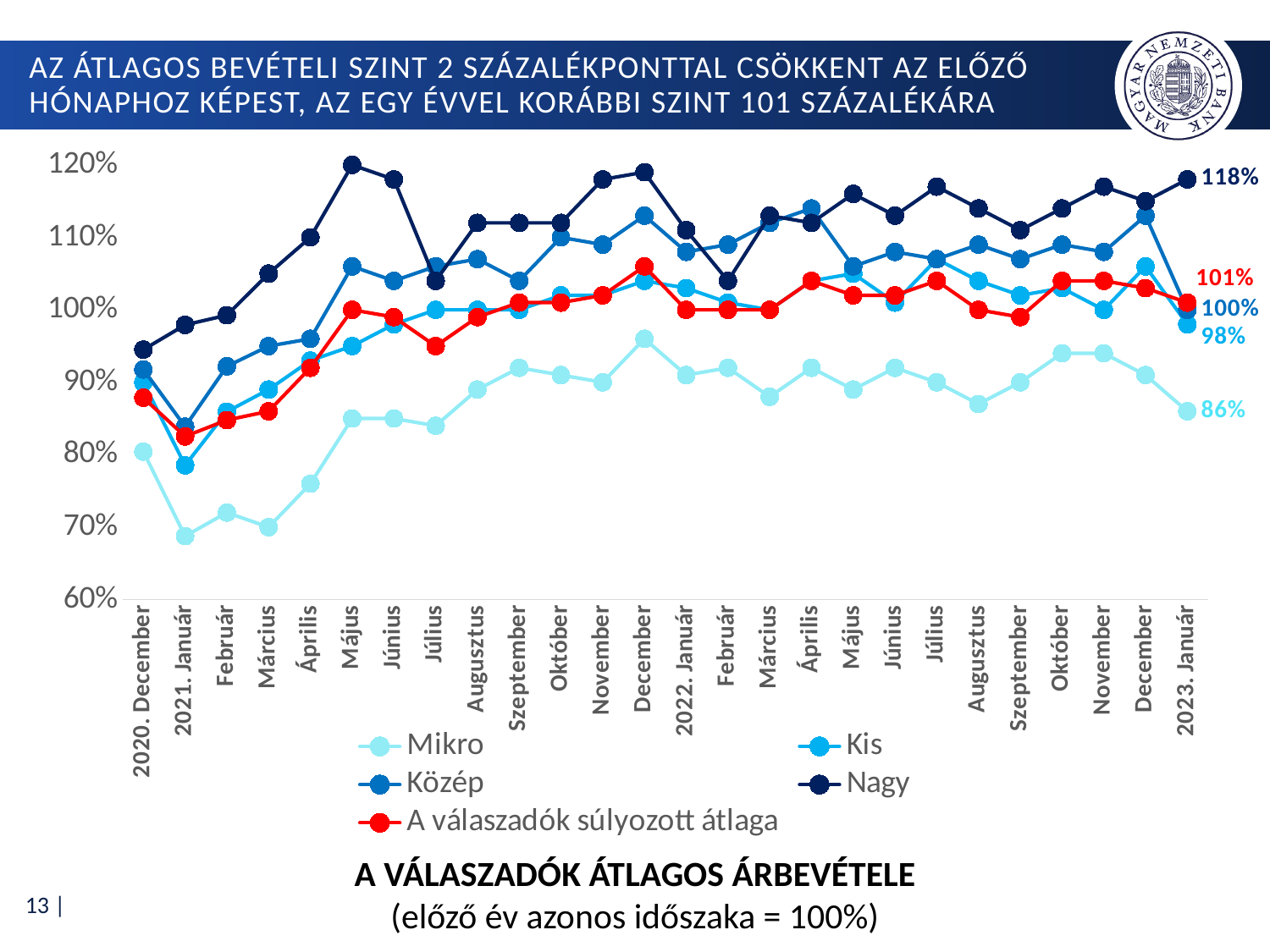
What is the value for Mikro in 2023. Január? 86% How many series does the legend list? 5 What is the value for Nagy in 2023. Január? 118% Which series has the lowest value in 2023. Január? Mikro What is the value for Kis in 2023. Január? 98% What is the difference between the Nagy and Mikro values in 2023. Január? 32 percentage points Does the Mikro series rise or fall from 2020. December to 2021. Január? fall Is the value for Mikro in 2021. Január greater or less than 80%? less Which series has the highest value in 2023. Január? Nagy What kind of chart is shown on the slide? line chart What is the value for A válaszadók súlyozott átlaga in 2023. Január? 101% In 2023. Január, which is larger: the value for Kis or the value for Közép? Közép